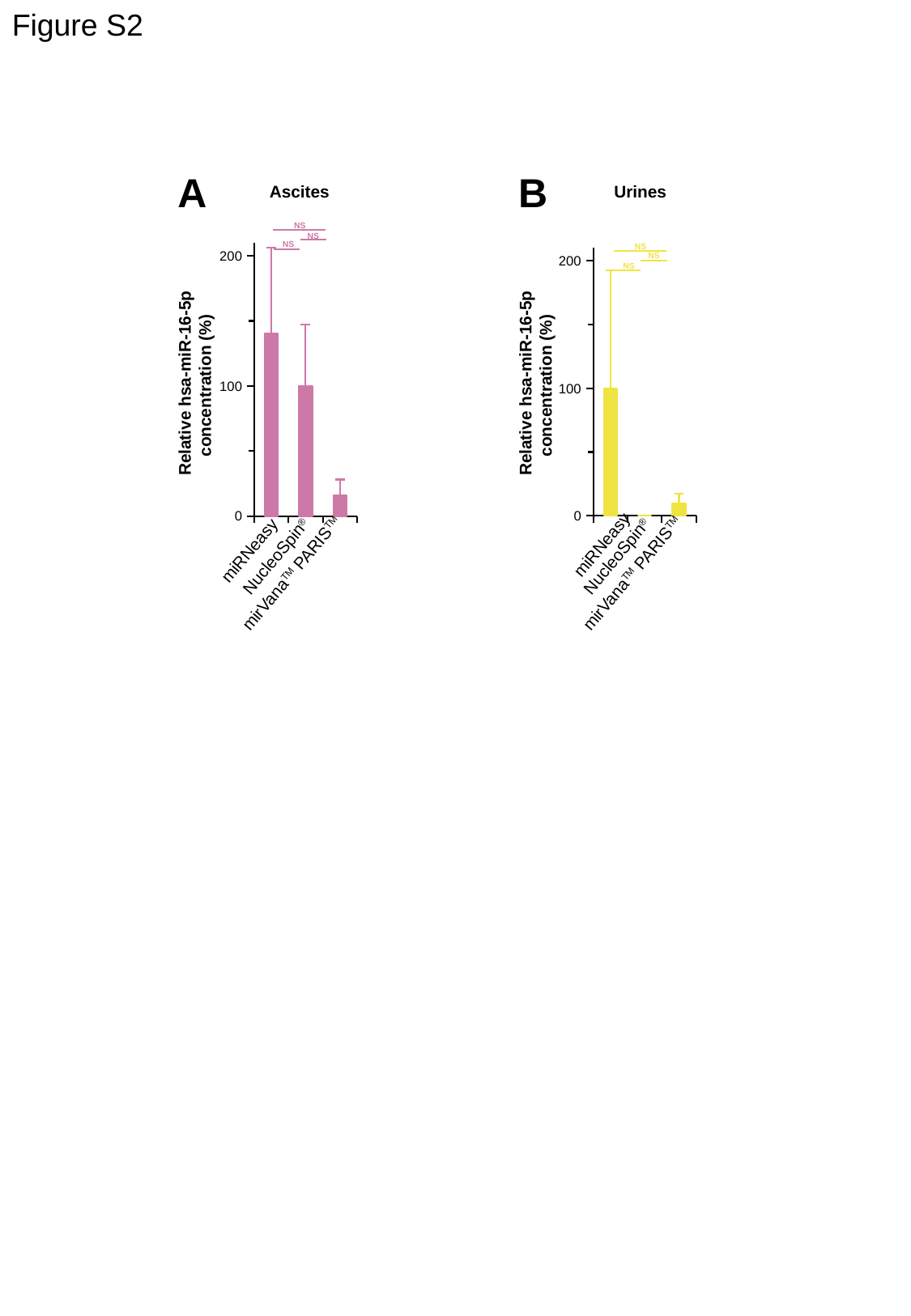
In the Urines chart, which is larger, the value for NucleoSpin or the value for mirVana PARIS? mirVana PARIS In the Ascites chart, is the value for miRNeasy greater or less than 100? greater In the Ascites chart, which is larger, the value for miRNeasy or the value for NucleoSpin? miRNeasy What is the title of the chart on the right side of the slide? Urines In the Ascites chart, what kind of chart is shown? bar chart In the Urines chart, which category has the highest relative hsa-miR-16-5p concentration? miRNeasy In the Urines chart, is the value for mirVana PARIS greater or less than 100? less In the Ascites chart, is the value for mirVana PARIS greater or less than 100? less In the Urines chart, what is the value for miRNeasy? 100 In the Ascites chart, which category has the highest relative hsa-miR-16-5p concentration? miRNeasy In the Ascites chart, how many categories are plotted on the x axis? 3 In the Ascites chart, which category has the lowest relative hsa-miR-16-5p concentration? mirVana PARIS